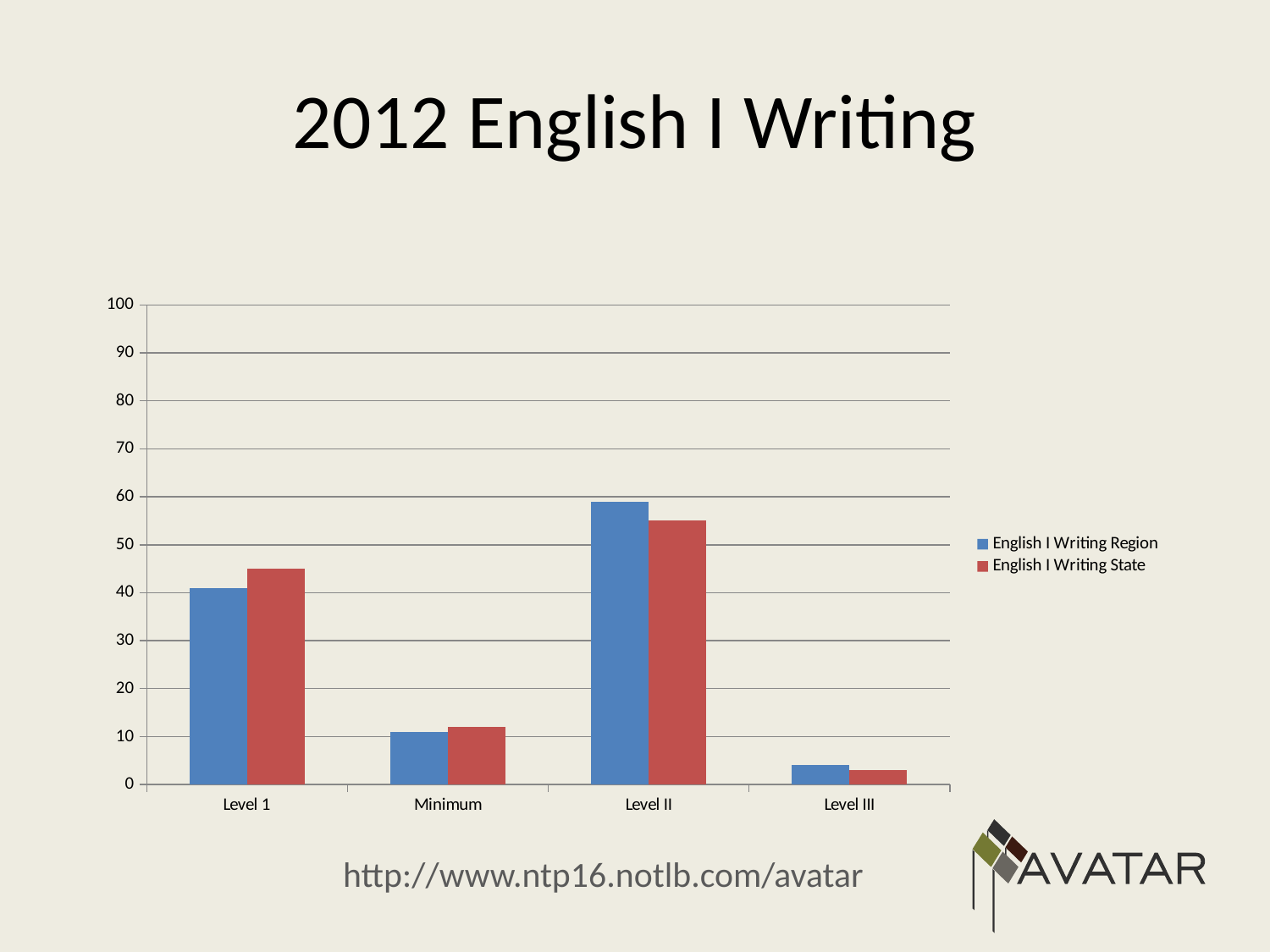
At Level 1, which is larger: English I Writing Region or English I Writing State? English I Writing State Is the value for English I Writing State at Level 1 greater or less than 50? less What is the title of the chart on the slide? 2012 English I Writing Is the value for English I Writing State at Level II greater or less than 50? greater Which category has the highest value for English I Writing Region? Level II Which category has the lowest value for English I Writing State? Level III How many series does the legend list? 2 How many categories are shown on the x axis? 4 At Level II, which is larger: English I Writing Region or English I Writing State? English I Writing Region What kind of chart is shown on the slide? bar chart Is the value for English I Writing Region at Minimum greater or less than 20? less